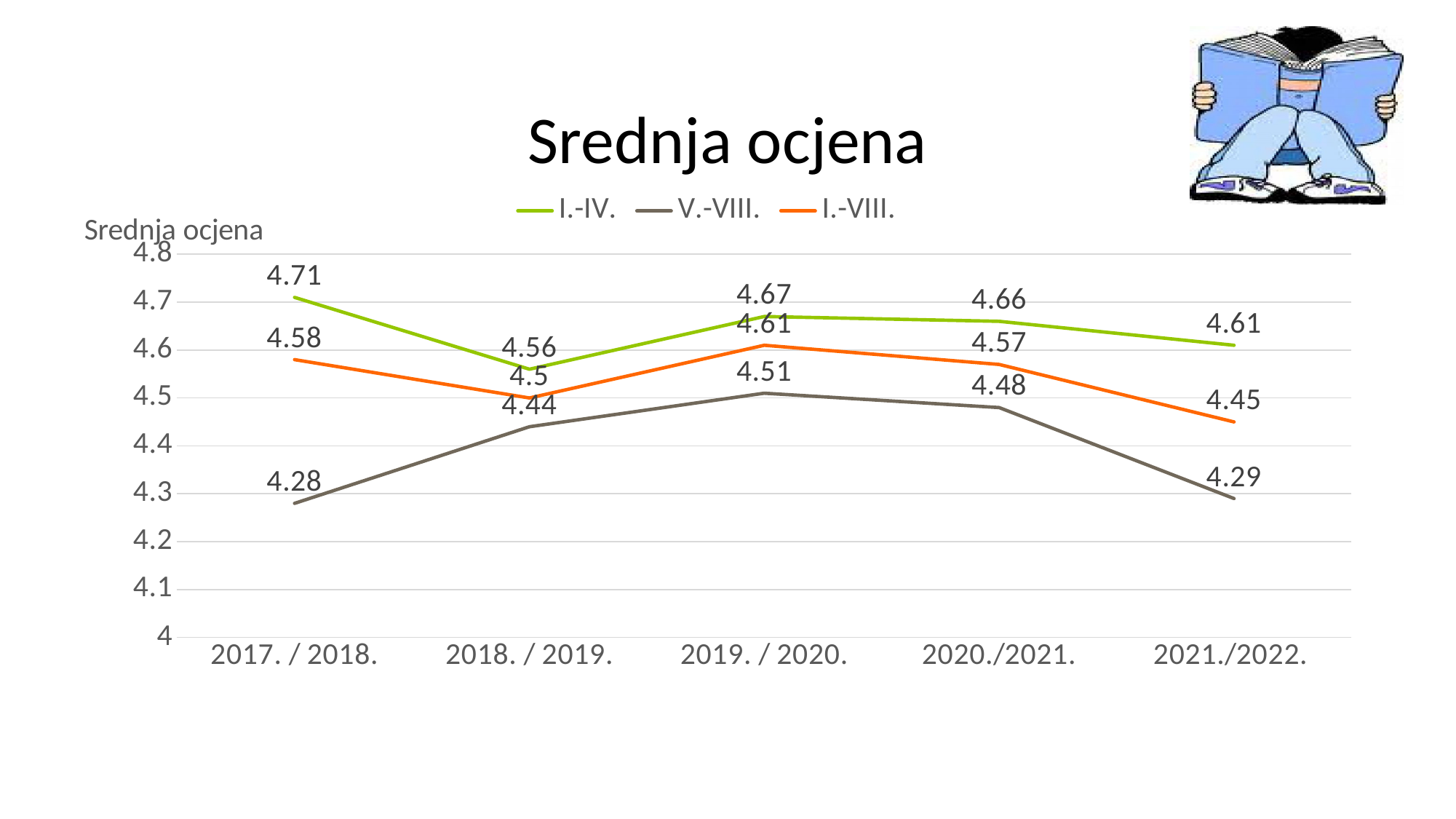
What is the value for I.-VIII. in 2019. / 2020.? 4.61 How many series does the legend list? 3 What is the difference between the I.-IV. and V.-VIII. values in 2017. / 2018.? 0.43 What is the value for V.-VIII. in 2021./2022.? 4.29 Which is larger in 2020./2021.: the I.-IV. value or the I.-VIII. value? I.-IV. How many school years are shown on the x axis? 5 In which school year is the I.-IV. series highest? 2017. / 2018. What is the value for I.-IV. in 2017. / 2018.? 4.71 Does the I.-VIII. series rise or fall from 2019. / 2020. to 2021./2022.? fall In which school year is the V.-VIII. series lowest? 2017. / 2018. Is the value for V.-VIII. in 2018. / 2019. greater or less than 4.4? greater What kind of chart is shown on the slide? line chart